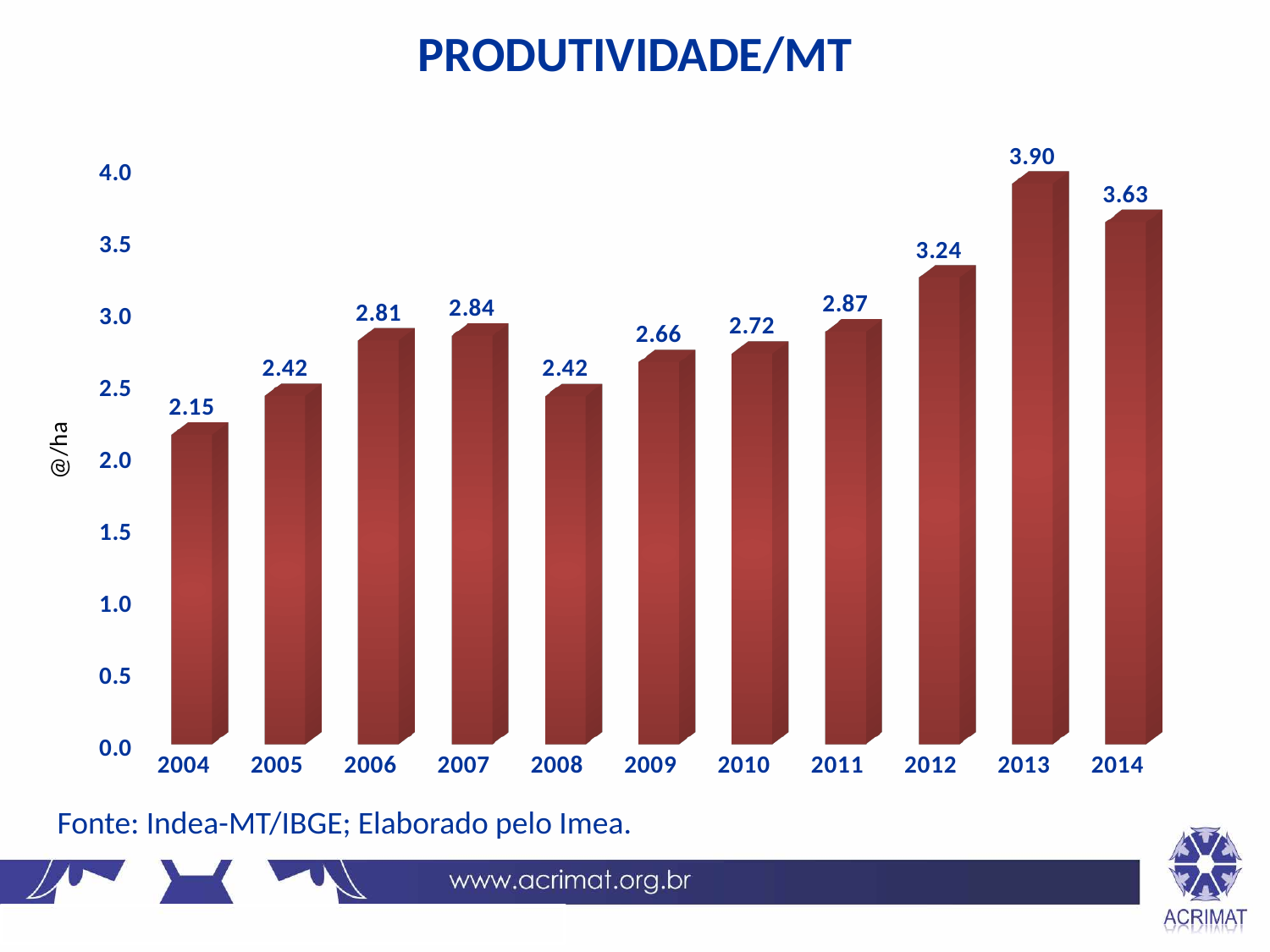
What is the difference between the values for 2013 and 2014? 0.27 What kind of chart is shown on the slide? bar chart What is the value shown for 2012? 3.24 What is the unit shown on the y axis label? @/ha What is the difference between the values for 2012 and 2004? 1.09 What is the productivity value for 2004? 2.15 Is the value for 2011 greater or less than 3.0? less How many years are shown on the x axis? 11 Which is larger, the value for 2007 or the value for 2009? 2007 What is the value shown for 2014? 3.63 Which year has the highest productivity? 2013 Which year has the lowest productivity? 2004